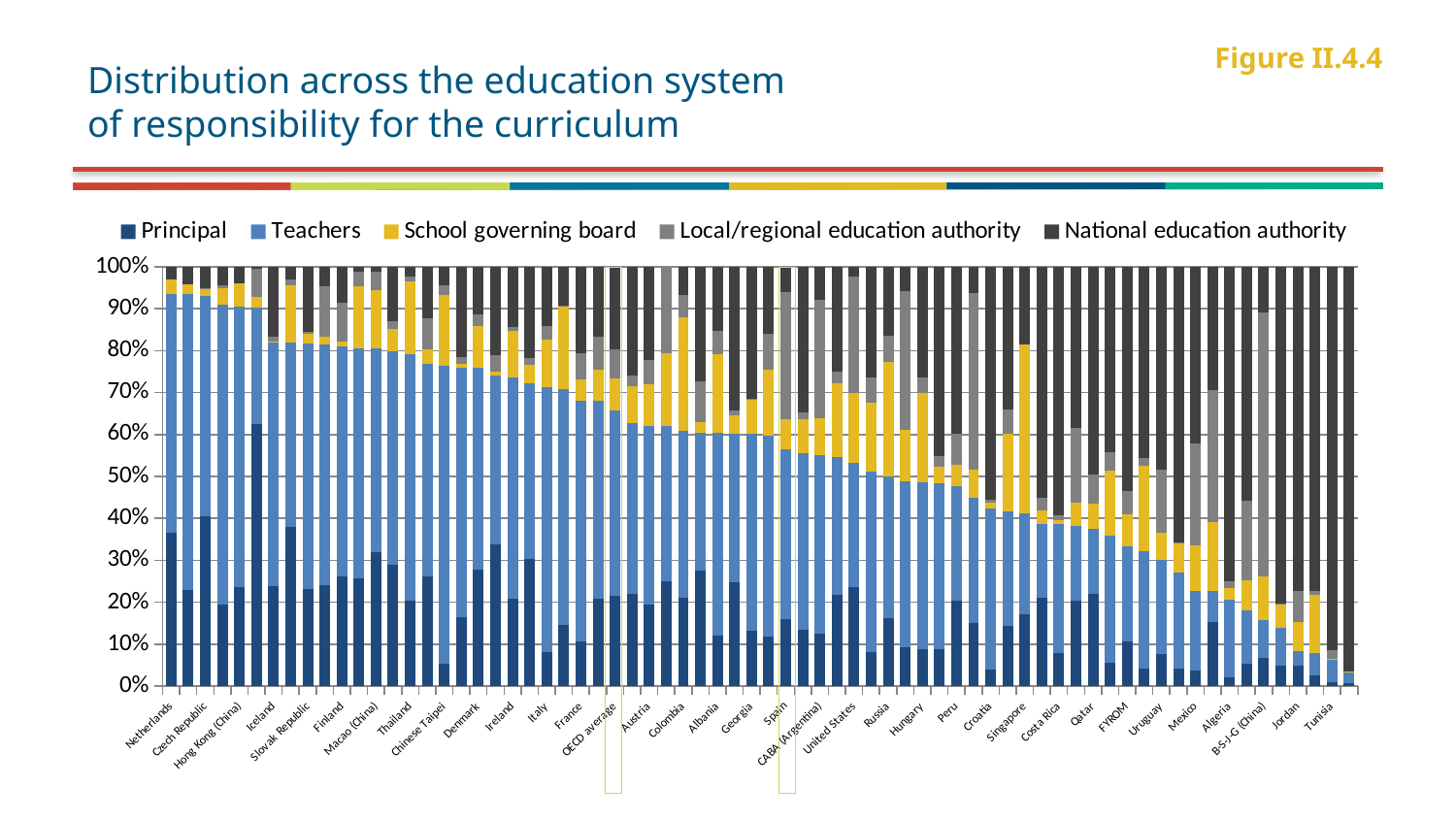
What is the title of the chart on the slide? Distribution across the education system of responsibility for the curriculum Which figure number is given for the chart? Figure II.4.4 Which is larger, the Principal share for Iceland or for Netherlands? Netherlands Is the Principal share for Netherlands greater or less than 30%? greater How many series does the legend list? 5 What kind of chart is shown on the slide? Stacked bar chart Does the National education authority share generally rise or fall from left to right across the countries? rise Does the combined Principal and Teachers share generally rise or fall from left to right across the countries? fall Which is larger, the Principal share for Netherlands or for Tunisia? Netherlands Is the Principal share for Tunisia greater or less than 10%? less Is the Principal share for Iceland greater or less than 50%? less